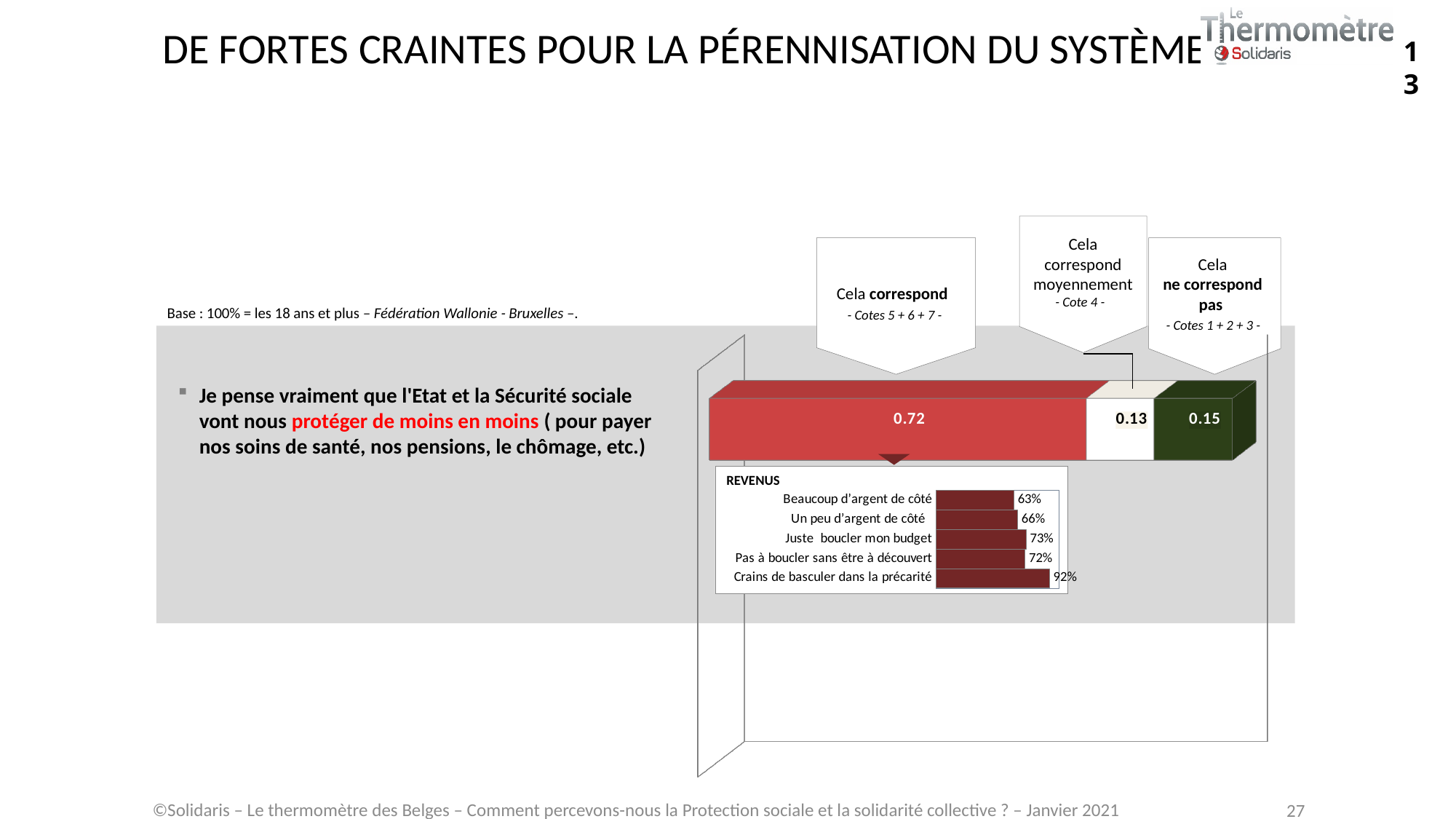
In the stacked bar chart at the top, which segment is the smallest? Cela correspond moyennement In the stacked bar chart at the top, which segment is the largest? Cela correspond In the REVENUS chart, how many categories are shown? 5 In the REVENUS chart, which category has the lowest value? Beaucoup d'argent de côté In the stacked bar chart at the top, what is the difference between the 'Cela correspond' and 'Cela ne correspond pas' segments? 0.57 In the REVENUS chart, which category has the highest value? Crains de basculer dans la précarité In the stacked bar chart at the top, what is the value for the 'Cela correspond moyennement' segment? 0.13 In the REVENUS chart, what is the value for 'Beaucoup d'argent de côté'? 63% In the stacked bar chart at the top, what is the value for the 'Cela ne correspond pas' segment? 0.15 In the REVENUS chart, what is the value for 'Crains de basculer dans la précarité'? 92% In the REVENUS chart, what is the difference between 'Juste boucler mon budget' and 'Un peu d'argent de côté'? 7% In the stacked bar chart at the top, what is the value for the 'Cela correspond' segment? 0.72